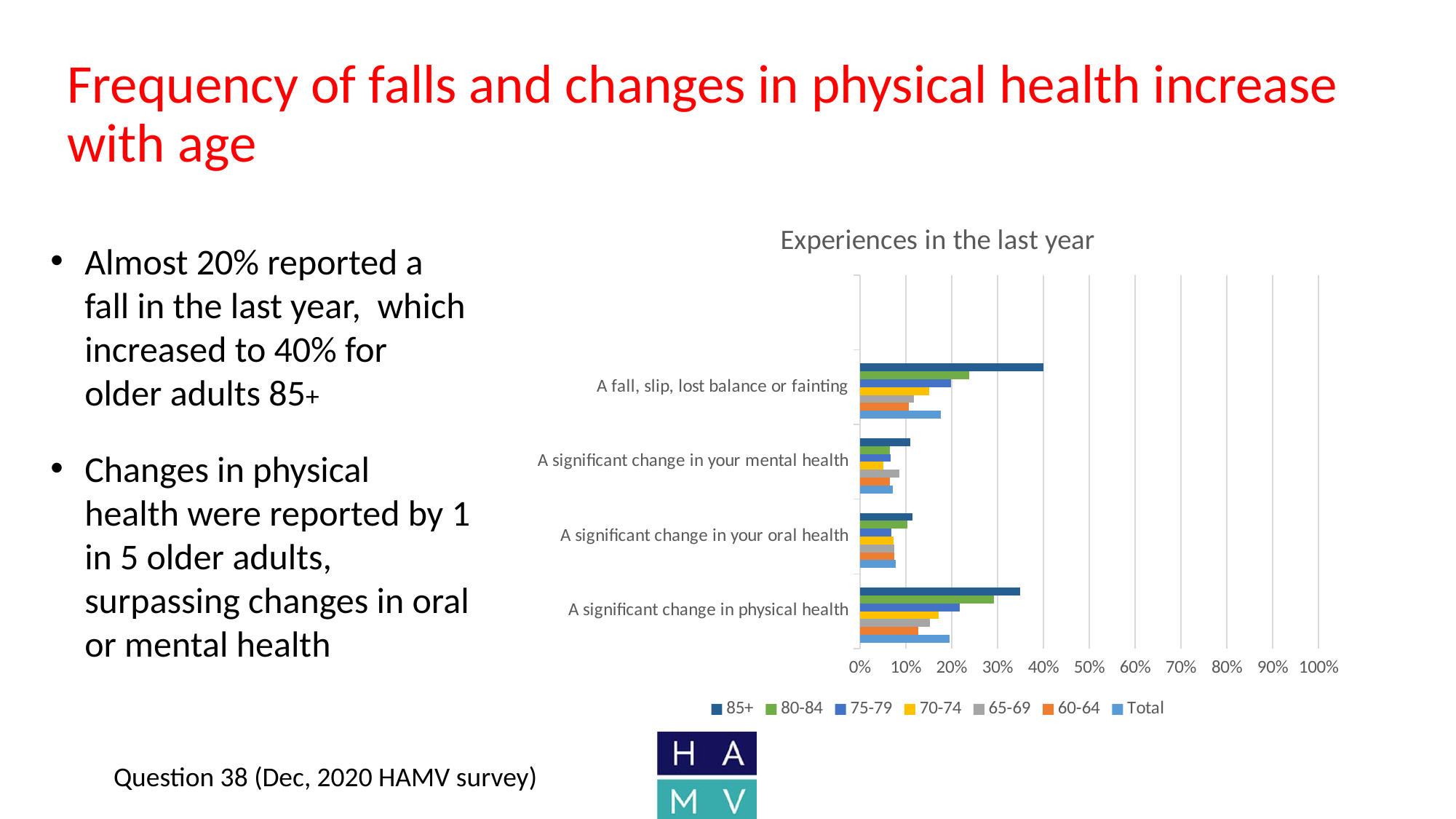
What is the title of the chart? Experiences in the last year Which series is listed first in the chart's legend? 85+ Which series has the highest value for 'A fall, slip, lost balance or fainting'? 85+ What kind of chart is shown on the slide? bar chart How many series does the chart's legend list? 7 For the 85+ series, which is larger: 'A fall, slip, lost balance or fainting' or 'A significant change in your oral health'? A fall, slip, lost balance or fainting Which category has the highest value for the 85+ series? A fall, slip, lost balance or fainting Is the Total value for 'A fall, slip, lost balance or fainting' greater or less than 20%? less Is the Total value for 'A significant change in your mental health' greater or less than 10%? less Is the 85+ value for 'A significant change in physical health' greater or less than 30%? greater How many categories are plotted on the chart? 4